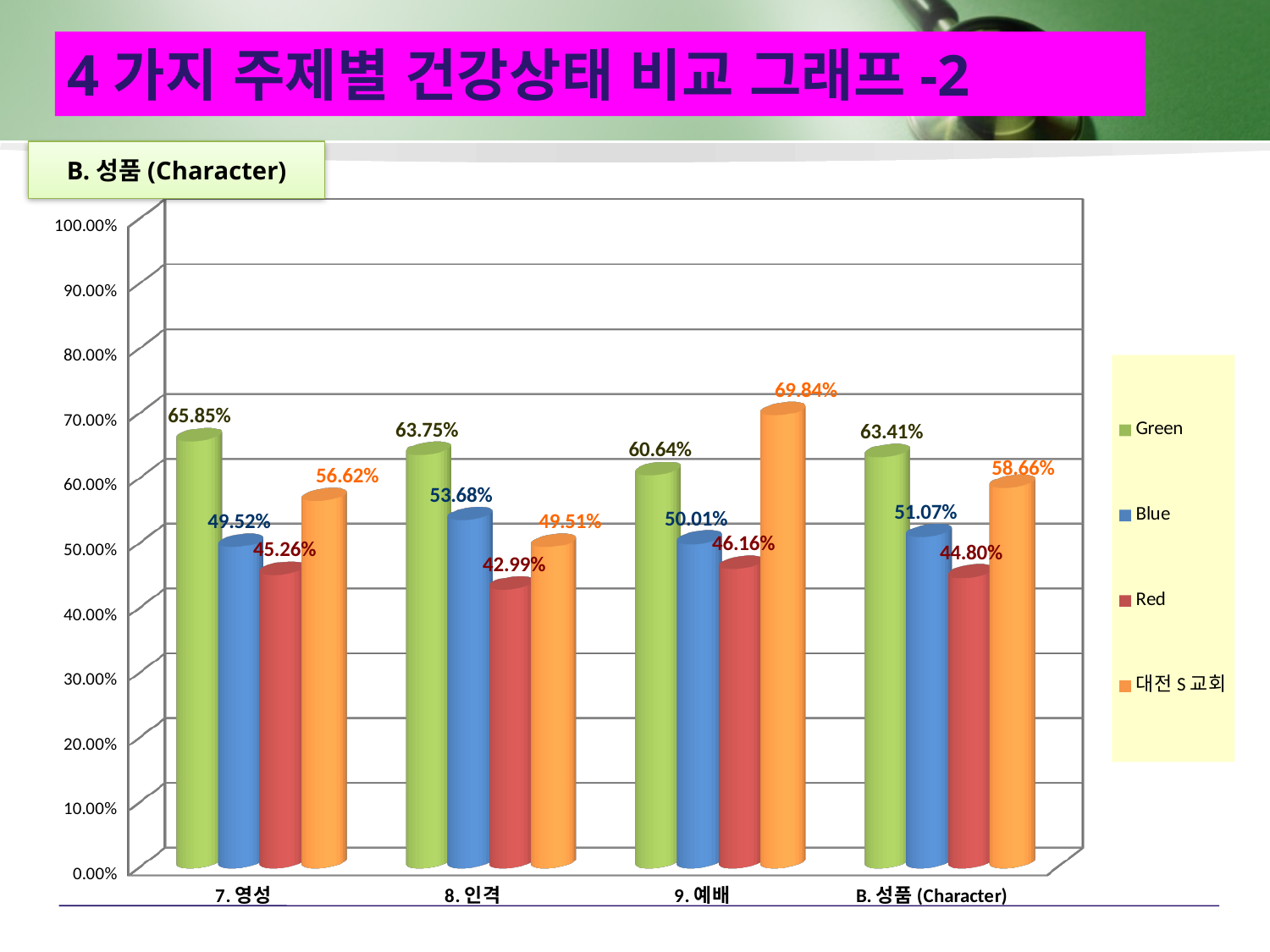
What is the value for Blue in the B. 성품 (Character) category? 51.07% What is the value for 대전 S 교회 in the 9. 예배 category? 69.84% How many categories are shown on the x axis? 4 What kind of chart is shown on the slide? Bar chart Which series is shown in orange in the legend? 대전 S 교회 What is the value for Green in the 7. 영성 category? 65.85% How many series does the legend list? 4 What is the value for Red in the 8. 인격 category? 42.99% What is the difference between the Green and Blue values in the 8. 인격 category? 10.07% Which is larger in the 9. 예배 category, the Green value or the 대전 S 교회 value? 대전 S 교회 Which category has the highest value for the Red series? 9. 예배 Which category has the lowest value for the 대전 S 교회 series? 8. 인격